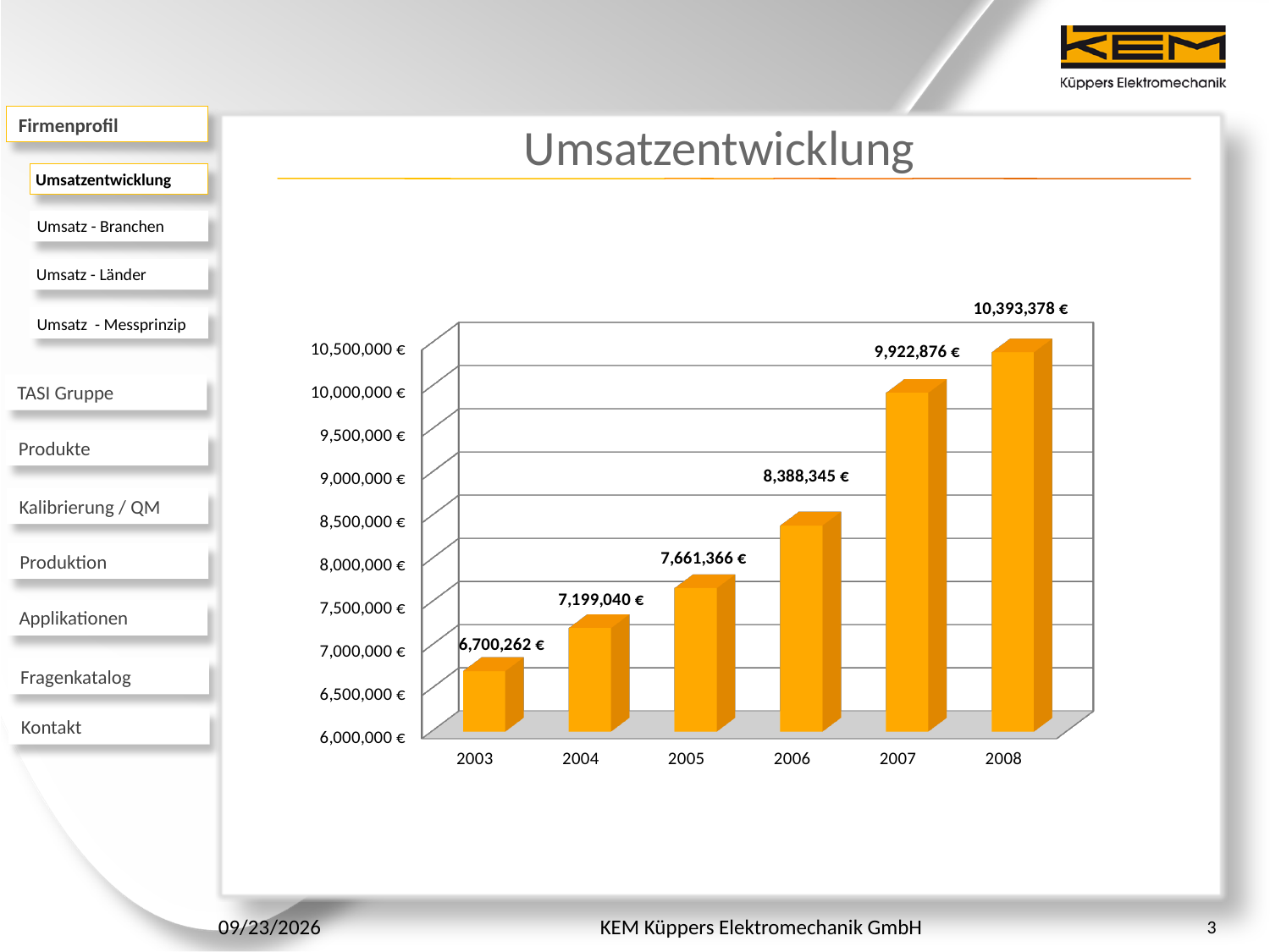
What is the difference between the values for 2004 and 2003? 498,778 € Which year has the highest value? 2008 What is the value for 2008? 10,393,378 € Which year has the lowest value? 2003 What is the value for 2006? 8,388,345 € What kind of chart is shown? bar chart What is the difference between the values for 2008 and 2007? 470,502 € Is the value for 2007 greater or less than 9,500,000 €? greater How many years are shown on the x axis? 6 Which is larger, the value for 2005 or the value for 2006? 2006 Do the values rise or fall from 2003 to 2008? rise What is the value for 2003? 6,700,262 €